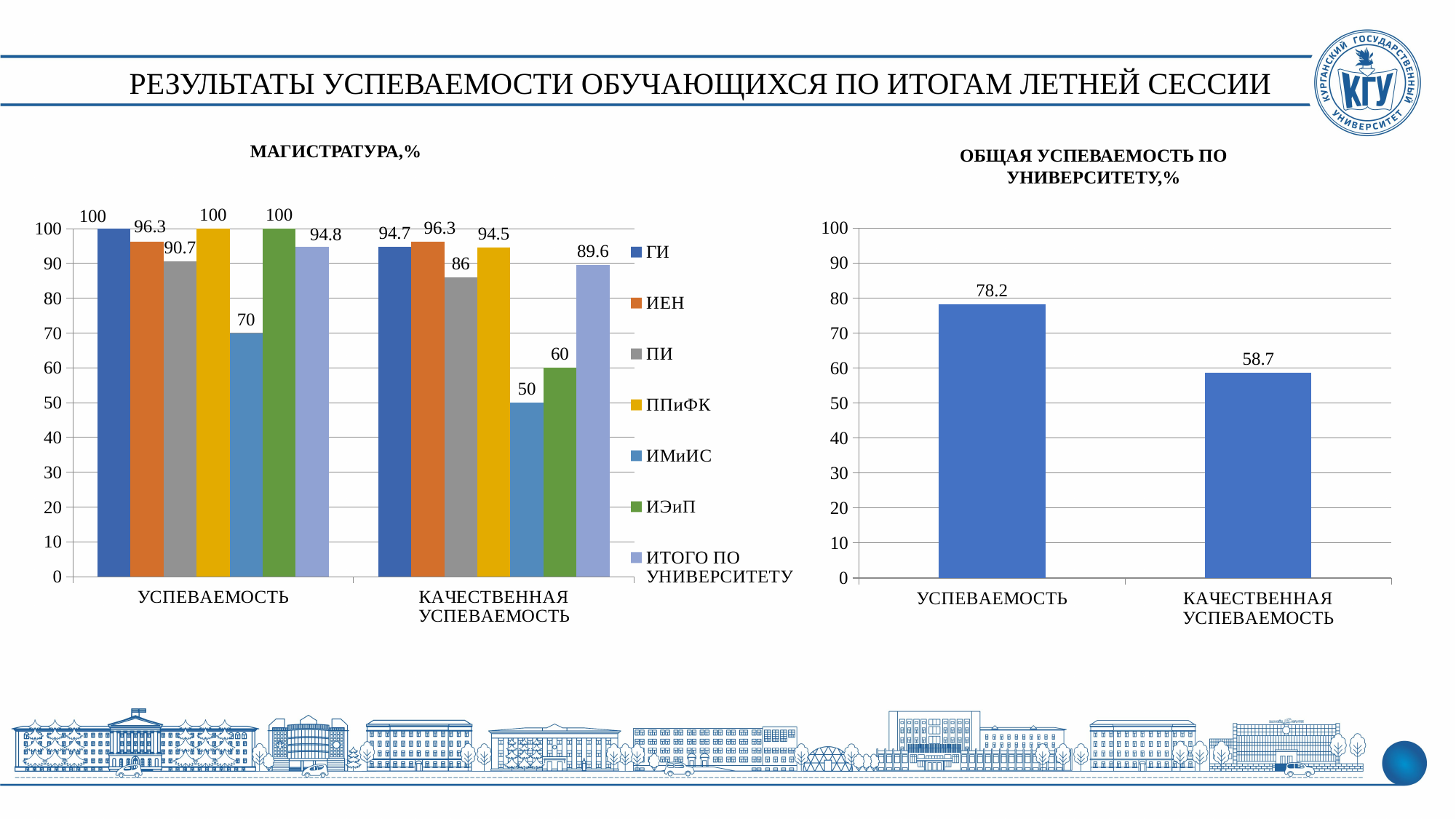
In the chart titled МАГИСТРАТУРА,%, what is the difference between the ИЭиП values for УСПЕВАЕМОСТЬ and КАЧЕСТВЕННАЯ УСПЕВАЕМОСТЬ? 40 In the chart titled МАГИСТРАТУРА,%, how many categories are shown on the x axis? 2 In the chart titled МАГИСТРАТУРА,%, which series has the lowest value in the КАЧЕСТВЕННАЯ УСПЕВАЕМОСТЬ category? ИМиИС In the chart titled МАГИСТРАТУРА,%, which is larger in the КАЧЕСТВЕННАЯ УСПЕВАЕМОСТЬ category: ГИ or ПИ? ГИ In the chart titled ОБЩАЯ УСПЕВАЕМОСТЬ ПО УНИВЕРСИТЕТУ,%, what is the value for КАЧЕСТВЕННАЯ УСПЕВАЕМОСТЬ? 58.7 In the chart titled МАГИСТРАТУРА,%, what is the value for ИМиИС in the УСПЕВАЕМОСТЬ category? 70 In the chart titled ОБЩАЯ УСПЕВАЕМОСТЬ ПО УНИВЕРСИТЕТУ,%, what is the difference between УСПЕВАЕМОСТЬ and КАЧЕСТВЕННАЯ УСПЕВАЕМОСТЬ? 19.5 In the chart titled МАГИСТРАТУРА,%, what is the value for ИТОГО ПО УНИВЕРСИТЕТУ in the КАЧЕСТВЕННАЯ УСПЕВАЕМОСТЬ category? 89.6 In the chart titled МАГИСТРАТУРА,%, what colour are the ППиФК bars? Yellow What kind of chart is the one titled ОБЩАЯ УСПЕВАЕМОСТЬ ПО УНИВЕРСИТЕТУ,%? Bar chart In the chart titled МАГИСТРАТУРА,%, what is the value for ПИ in the КАЧЕСТВЕННАЯ УСПЕВАЕМОСТЬ category? 86 In the chart titled МАГИСТРАТУРА,%, how many series does the legend list? 7